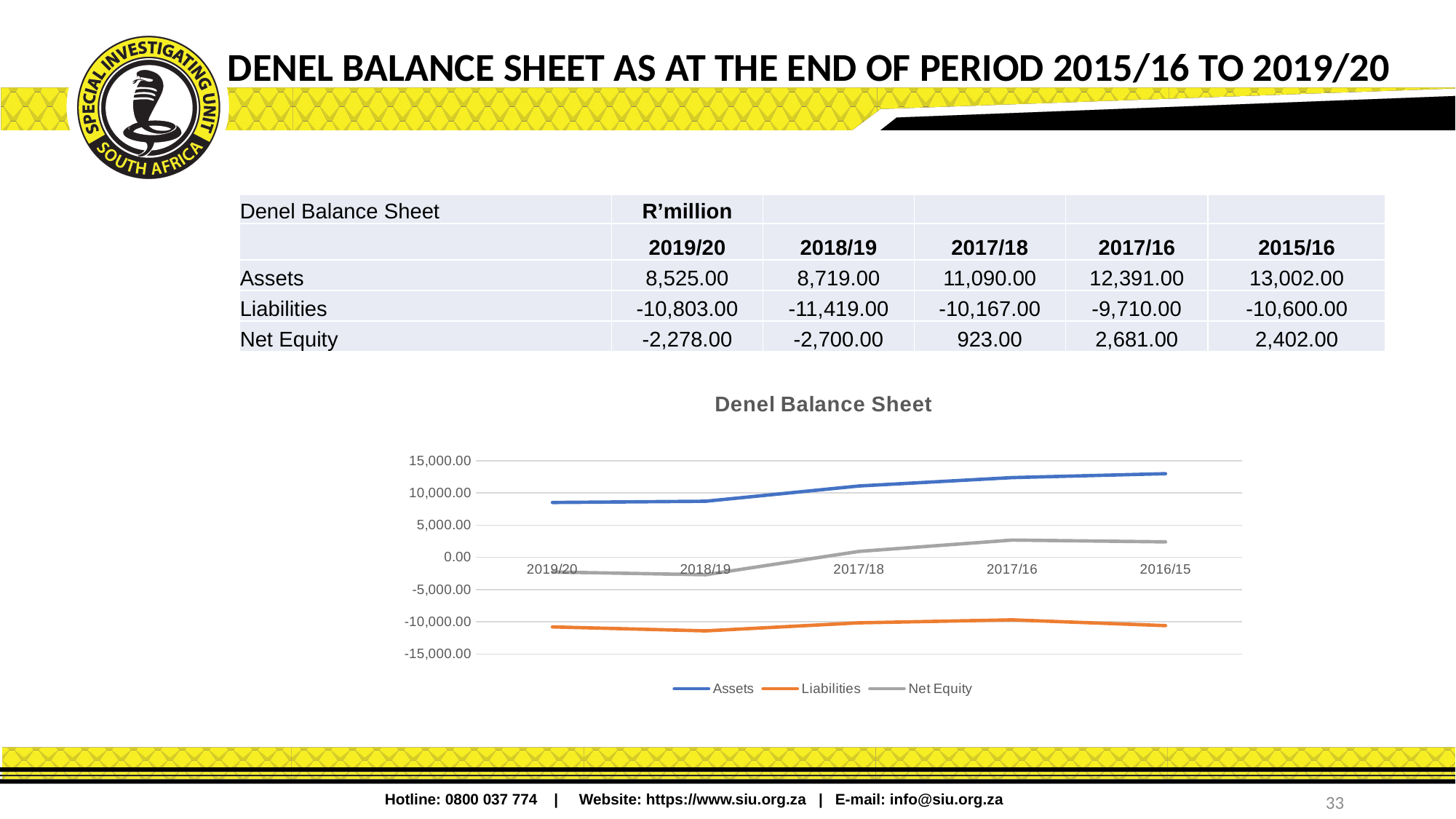
What is the difference between the Assets values for 2017/16 and 2017/18? 1,301.00 How many periods are plotted along the x axis of the chart? 5 What is the value of Liabilities for 2017/18? -10,167.00 In which period is the Assets value lowest? 2019/20 What is the title of the chart? Denel Balance Sheet Is the Assets value for 2017/18 greater or less than 10,000.00? greater Is the Liabilities value for 2019/20 greater or less than -10,000.00? less Which is larger, Net Equity for 2017/16 or Net Equity for 2015/16? 2017/16 What is the value of Net Equity for 2018/19? -2,700.00 What kind of chart is shown on the slide? line chart What is the value of Assets for 2019/20? 8,525.00 How many series does the chart legend list? 3